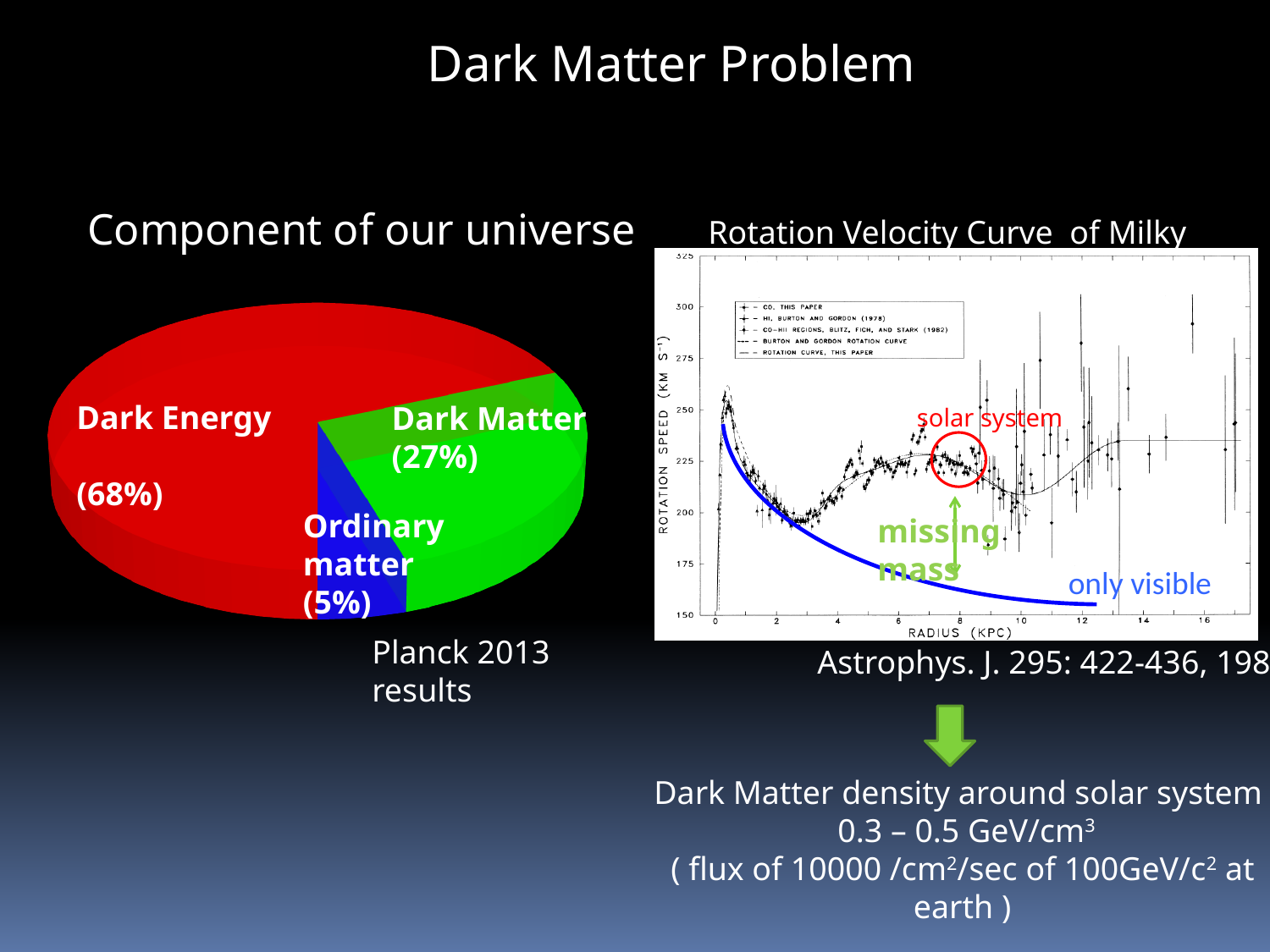
In the 'Rotation Velocity Curve of Milky' chart, what is the label of the x axis? RADIUS (KPC) In the 'Rotation Velocity Curve of Milky' chart, is the rotation speed at the circled solar system position greater or less than 200? greater In the 'Component of our universe' pie chart, what percentage is Ordinary matter? 5% How many slices does the 'Component of our universe' pie chart have? 3 In the 'Component of our universe' pie chart, which component has the smallest share? Ordinary matter What kind of chart is 'Component of our universe'? Pie chart In the 'Component of our universe' pie chart, which component has the largest share? Dark Energy In the 'Component of our universe' pie chart, what percentage is Dark Matter? 27% In the 'Component of our universe' pie chart, which is larger, Dark Matter or Ordinary matter? Dark Matter In the 'Component of our universe' pie chart, what percentage is Dark Energy? 68% In the 'Rotation Velocity Curve of Milky' chart, is the 'only visible' blue curve at a radius of 12 kpc greater or less than 175? less In the 'Component of our universe' pie chart, what is the difference in percentage points between Dark Energy and Dark Matter? 41